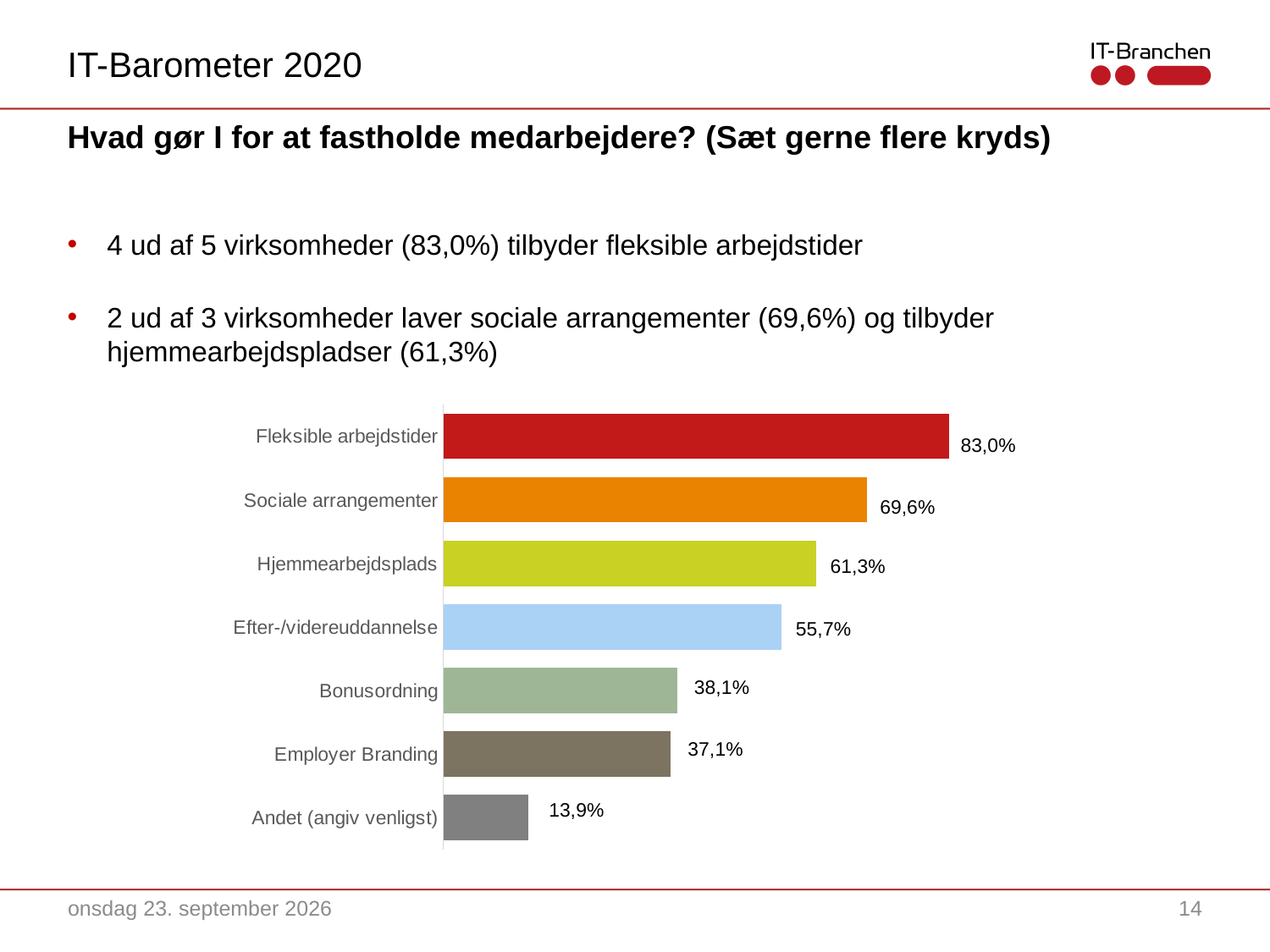
Which category has the highest value? Fleksible arbejdstider How many categories are shown in the chart? 7 Which is larger, the value for Hjemmearbejdsplads or the value for Efter-/videreuddannelse? Hjemmearbejdsplads What is the value for Fleksible arbejdstider? 83,0% What is the difference between the values for Sociale arrangementer and Hjemmearbejdsplads? 8,3% Do the values rise or fall from the top bar to the bottom bar? fall What colour is the bar for Sociale arrangementer? orange What kind of chart is shown on the slide? bar chart What is the value for Andet (angiv venligst)? 13,9% What is the value for Efter-/videreuddannelse? 55,7% Which category has the lowest value? Andet (angiv venligst) What is the difference between the values for Bonusordning and Employer Branding? 1,0%